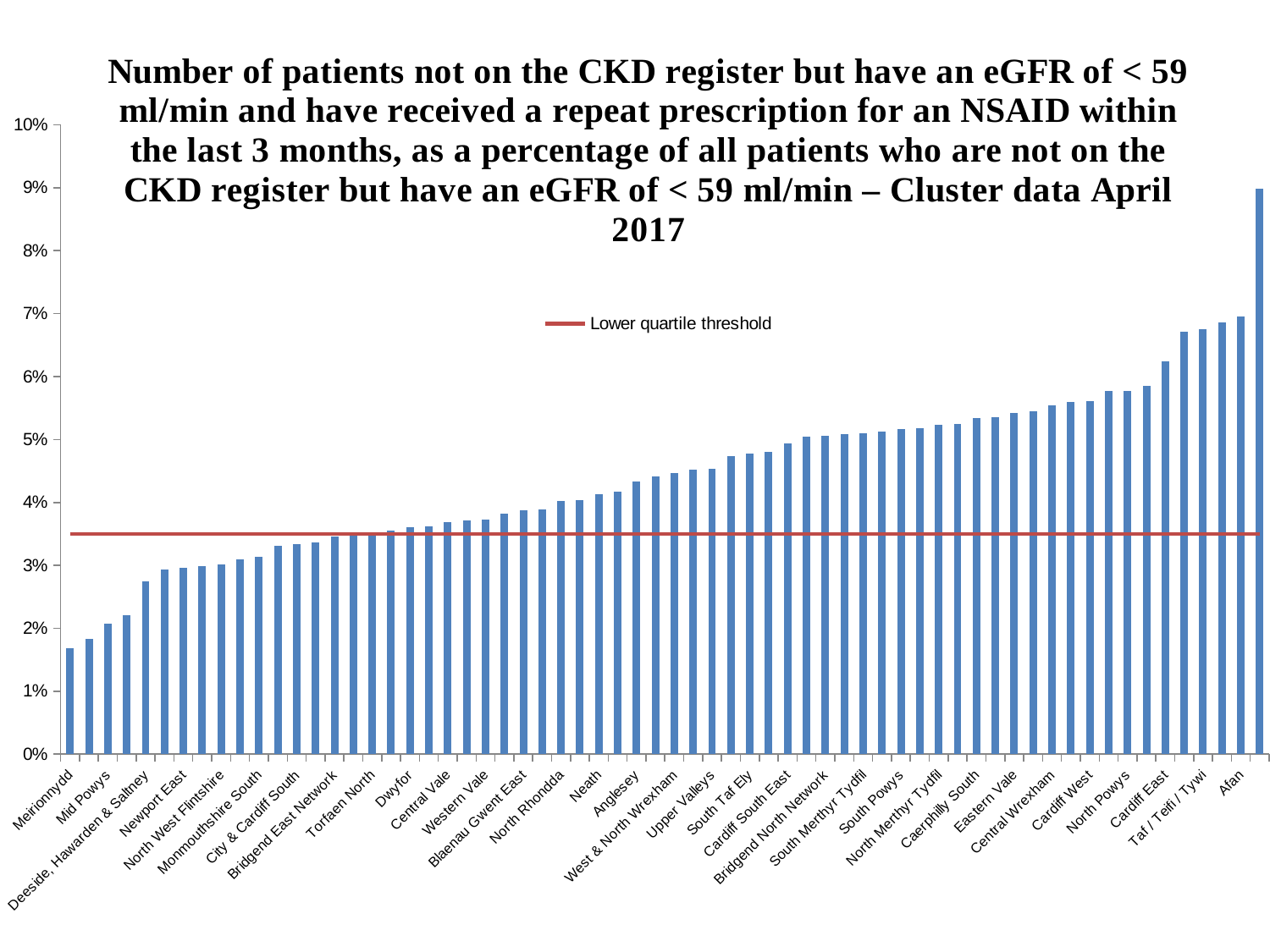
Is the value for Newport East greater or less than 4%? less Do the bar values rise or fall from left to right along the x axis? Rise What entry does the legend list? Lower quartile threshold Is the value for Mid Powys greater or less than 3%? less Is the value for Afan greater or less than 6%? greater According to the title, which month's cluster data does the chart show? April 2017 What kind of chart is shown on the slide? Bar chart Which has the larger value, Afan or Meirionnydd? Afan